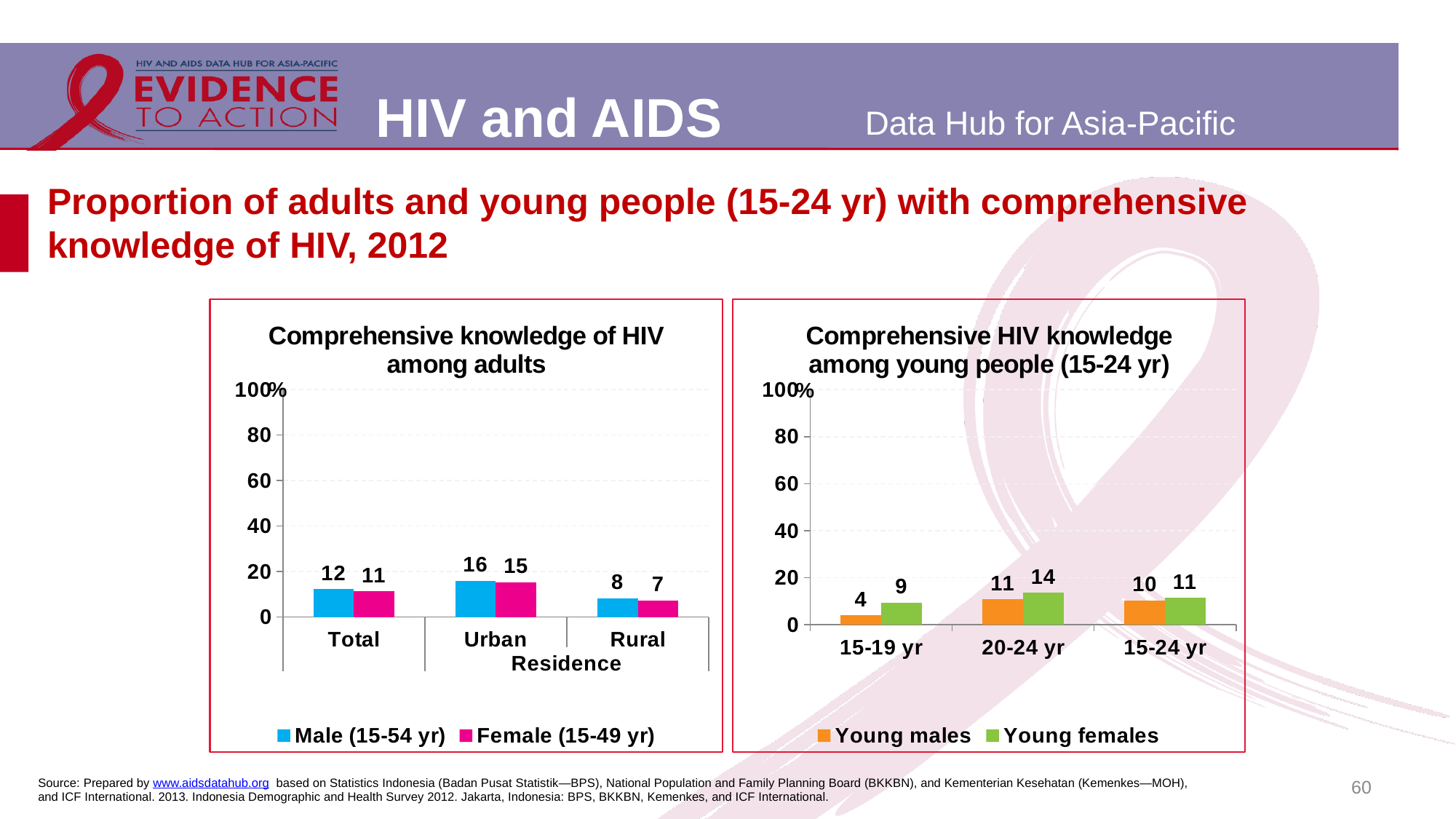
What kind of chart is the 'Comprehensive knowledge of HIV among adults' chart? Bar chart In the 'Comprehensive HIV knowledge among young people (15-24 yr)' chart, what is the value for Young males in the 15-19 yr group? 4 In the 'Comprehensive HIV knowledge among young people (15-24 yr)' chart, which age group has the lowest value for Young males? 15-19 yr In the 'Comprehensive knowledge of HIV among adults' chart, what is the difference between the Male and Female values in the Total category? 1 In the 'Comprehensive knowledge of HIV among adults' chart, how many series does the legend list? 2 In the 'Comprehensive knowledge of HIV among adults' chart, which category has the highest value for Male (15-54 yr)? Urban In the 'Comprehensive HIV knowledge among young people (15-24 yr)' chart, what is the difference between Young females and Young males in the 20-24 yr group? 3 In the 'Comprehensive HIV knowledge among young people (15-24 yr)' chart, what is the value for Young females in the 20-24 yr group? 14 In the 'Comprehensive HIV knowledge among young people (15-24 yr)' chart, which is larger in the 15-19 yr group: Young males or Young females? Young females In the 'Comprehensive knowledge of HIV among adults' chart, what is the value for Female (15-49 yr) in the Rural category? 7 In the 'Comprehensive knowledge of HIV among adults' chart, what is the value for Male (15-54 yr) in the Urban category? 16 In the 'Comprehensive HIV knowledge among young people (15-24 yr)' chart, how many age groups are shown on the x axis? 3